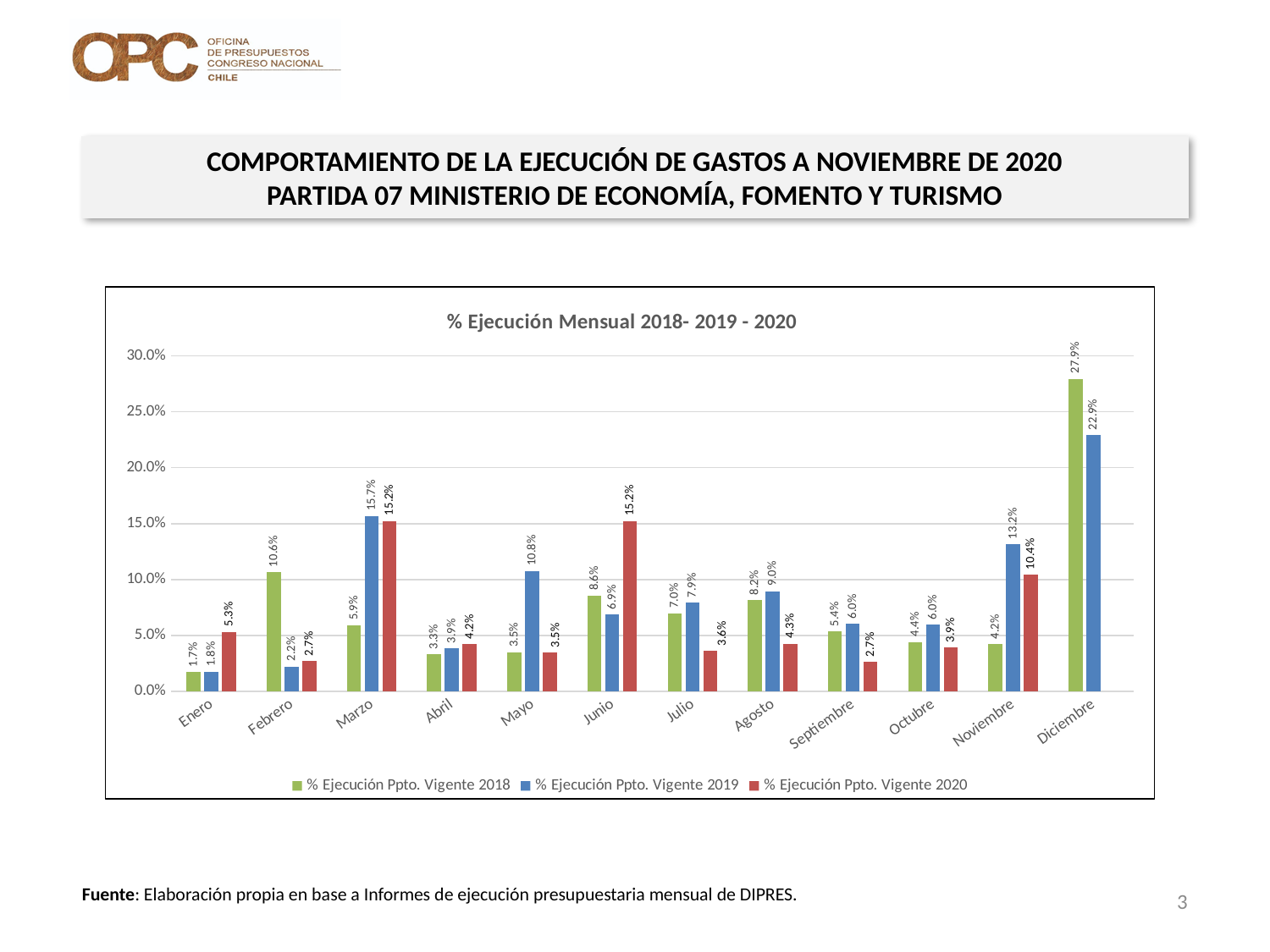
How many months are shown on the x axis? 12 Which month has the highest value for % Ejecución Ppto. Vigente 2018? Diciembre What is the value for % Ejecución Ppto. Vigente 2018 in Diciembre? 27.9% What kind of chart is shown on the slide? Bar chart What is the difference between the 2018 and 2019 values in Diciembre? 5.0% What is the title of the chart? % Ejecución Mensual 2018- 2019 - 2020 What is the value for % Ejecución Ppto. Vigente 2019 in Marzo? 15.7% How many series does the legend list? 3 Which month has the lowest value for % Ejecución Ppto. Vigente 2019? Enero In Febrero, which series has the larger value: 2018 or 2019? % Ejecución Ppto. Vigente 2018 What is the value for % Ejecución Ppto. Vigente 2020 in Junio? 15.2% What is the difference between the 2019 and 2020 values in Noviembre? 2.8%